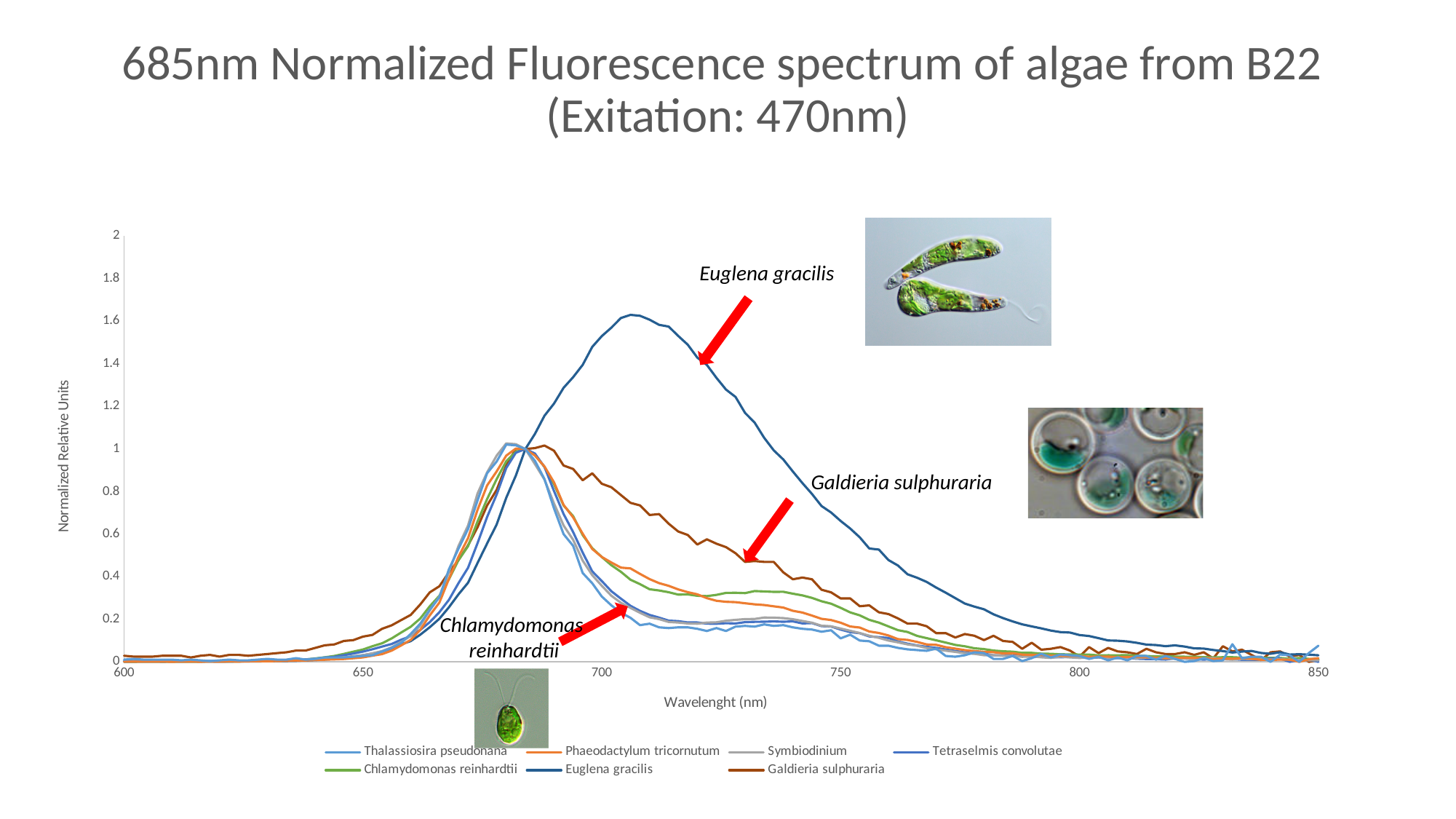
What is the label of the x axis? Wavelenght (nm) Is the peak value of the Euglena gracilis curve greater or less than 1.4? greater At 750 nm, which is larger, the value for Euglena gracilis or the value for Galdieria sulphuraria? Euglena gracilis How many series does the legend list? 7 How many labelled tick values are shown on the x axis? 6 What kind of chart is shown on the slide? line chart Which series reaches the highest peak value on the chart? Euglena gracilis At 750 nm, is the value for Euglena gracilis greater or less than 0.4? greater Does the Euglena gracilis curve rise or fall between 710 nm and 850 nm? fall Is the peak value of the Euglena gracilis curve greater or less than 1.8? less What is the title of the chart? 685nm Normalized Fluorescence spectrum of algae from B22 (Exitation: 470nm)